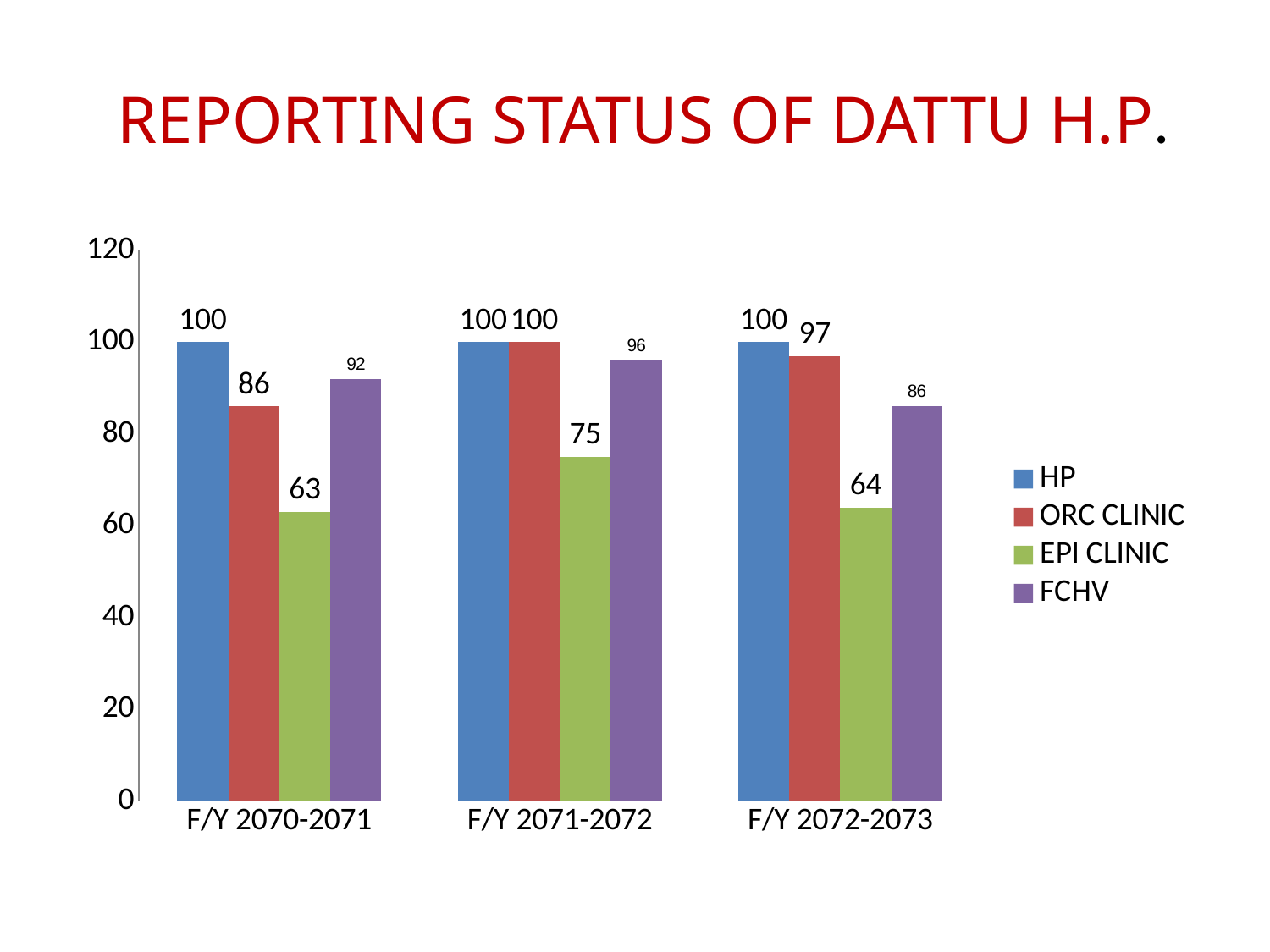
Is the value for EPI CLINIC in F/Y 2070-2071 greater or less than 80? less Which is larger, the FCHV value in F/Y 2071-2072 or the FCHV value in F/Y 2072-2073? F/Y 2071-2072 What is the value for EPI CLINIC in F/Y 2071-2072? 75 How many fiscal year categories are shown on the x axis? 3 What kind of chart is shown on the slide? bar chart What is the difference between the ORC CLINIC and EPI CLINIC values in F/Y 2070-2071? 23 What is the value for FCHV in F/Y 2070-2071? 92 Which series has the lowest value in F/Y 2072-2073? EPI CLINIC Which series has the highest value in F/Y 2070-2071? HP What is the title of the slide? REPORTING STATUS OF DATTU H.P. How many series does the legend list? 4 What is the value for ORC CLINIC in F/Y 2072-2073? 97